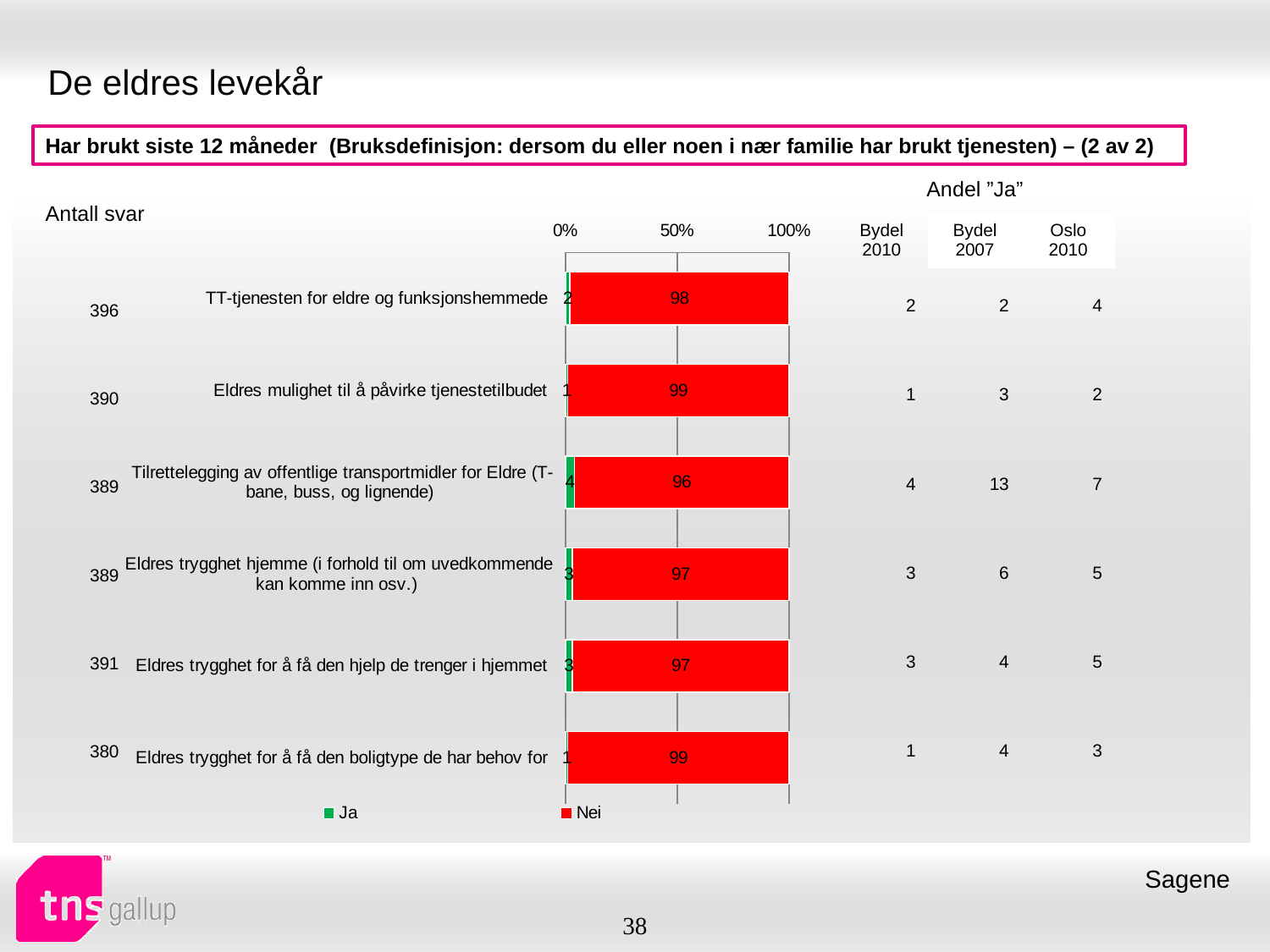
How many categories are plotted in the chart? 6 Is the "Nei" value for "Eldres trygghet hjemme (i forhold til om uvedkommende kan komme inn osv.)" greater or less than 50%? greater What is the "Nei" value for "Eldres trygghet for å få den boligtype de har behov for"? 99 How many series does the chart legend list? 2 Which is larger, the "Nei" value for "TT-tjenesten for eldre og funksjonshemmede" or for "Tilrettelegging av offentlige transportmidler for Eldre (T-bane, buss, og lignende)"? TT-tjenesten for eldre og funksjonshemmede What is the "Nei" value for "Tilrettelegging av offentlige transportmidler for Eldre (T-bane, buss, og lignende)"? 96 What are the two legend entries of the chart? Ja and Nei What is the "Nei" value for "TT-tjenesten for eldre og funksjonshemmede"? 98 What kind of chart is shown on the slide? bar chart What is the difference between the "Nei" values for "Eldres mulighet til å påvirke tjenestetilbudet" and "Tilrettelegging av offentlige transportmidler for Eldre (T-bane, buss, og lignende)"? 3 What is the "Nei" value for "Eldres trygghet for å få den hjelp de trenger i hjemmet"? 97 Which category has the lowest "Nei" value? Tilrettelegging av offentlige transportmidler for Eldre (T-bane, buss, og lignende)